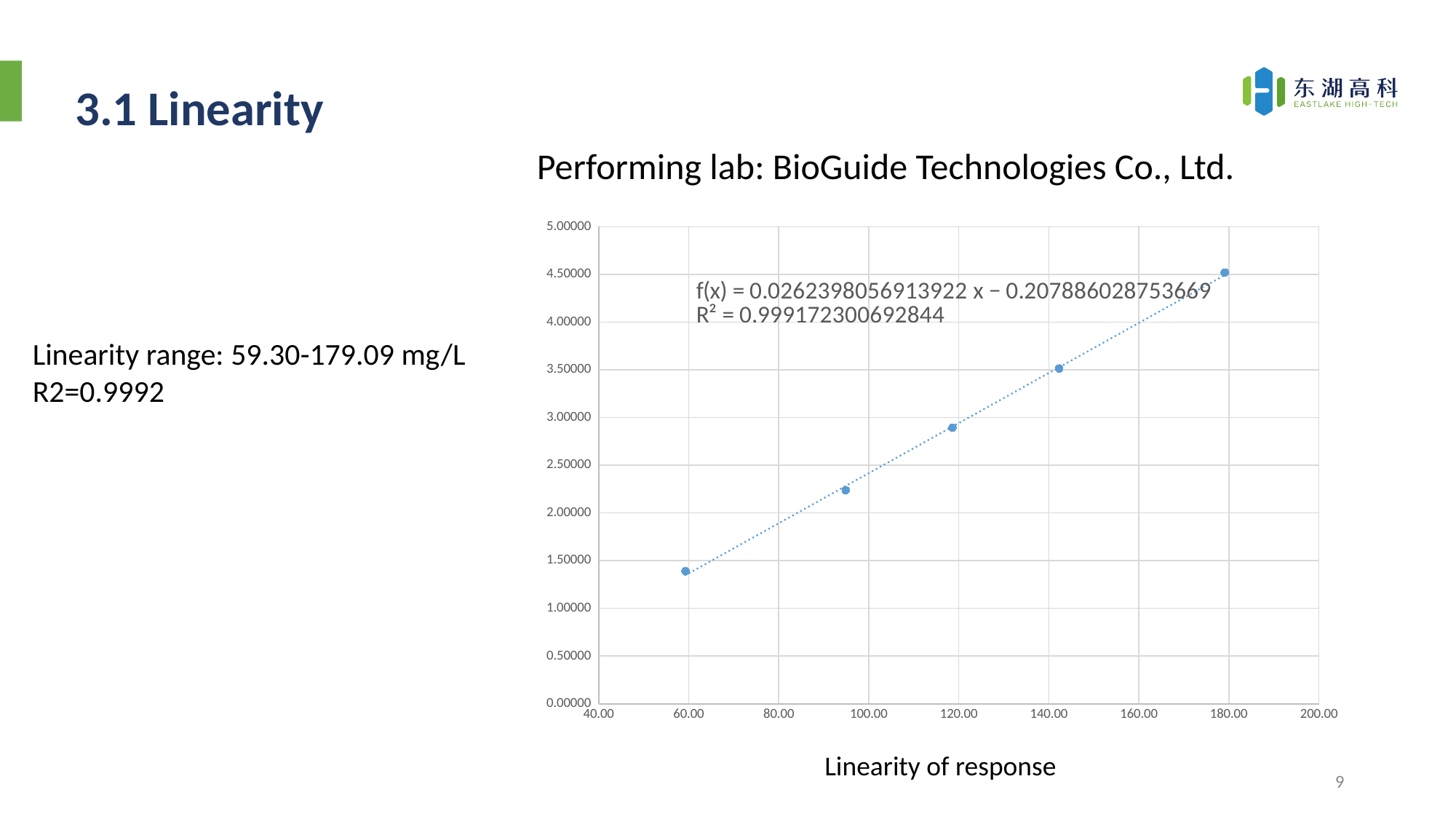
What R² value is printed on the chart? R² = 0.999172300692844 How many data points are plotted in the chart? 5 Is the value of the leftmost data point (near x = 60.00) greater or less than 1.50000? less Is the value of the data point near x = 140.00 greater or less than 3.00000? greater Which data point has the highest y value, the one near x = 60.00 or the one near x = 180.00? The one near x = 180.00 Is the value of the rightmost data point (near x = 180.00) greater or less than 4.00000? greater Which data point has the lowest y value in the chart? The leftmost point, near x = 60.00 What kind of chart is shown on the slide? Scatter plot What is the title shown below the chart? Linearity of response Do the plotted values rise or fall as the x value increases? Rise